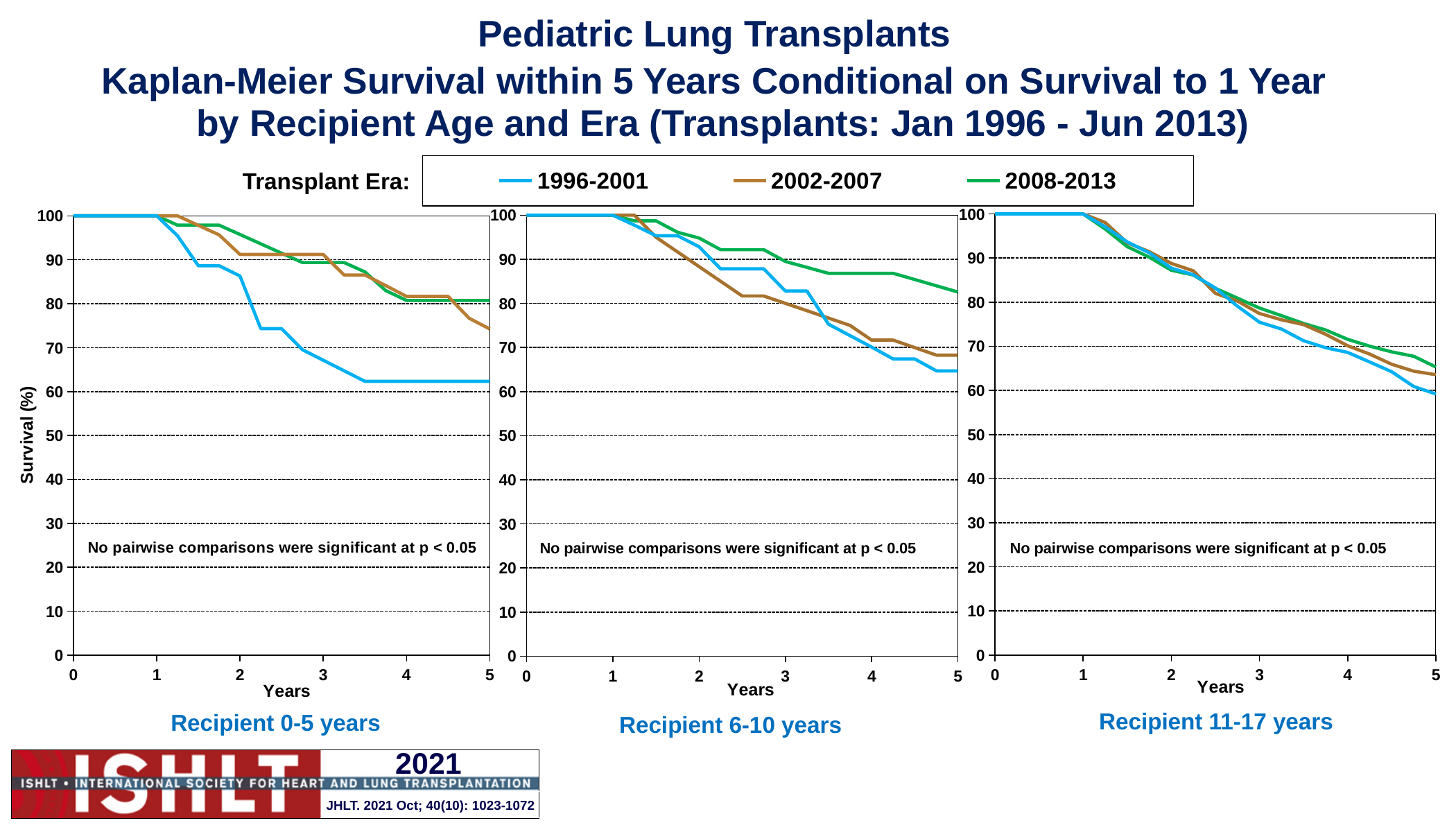
In the 'Recipient 0-5 years' chart, is the survival for the 1996-2001 era at year 5 greater or less than 70? less How many transplant eras does the legend list? 3 In the 'Recipient 0-5 years' chart, is the survival for the 2002-2007 era at year 5 greater or less than 80? less In the 'Recipient 0-5 years' chart, which era has the lowest survival at year 5? 1996-2001 In the 'Recipient 6-10 years' chart, which era has the highest survival at year 5? 2008-2013 In the 'Recipient 6-10 years' chart, do the survival curves rise or fall as years increase? Fall In the 'Recipient 11-17 years' chart, at year 5 which era has higher survival, 1996-2001 or 2008-2013? 2008-2013 How many survival charts are shown on the slide? 3 In the 'Recipient 6-10 years' chart, is the survival for the 2008-2013 era at year 5 greater or less than 80? greater What is the label on the vertical axis of the charts? Survival (%) What kind of chart is used in the 'Recipient 0-5 years' panel? Line chart